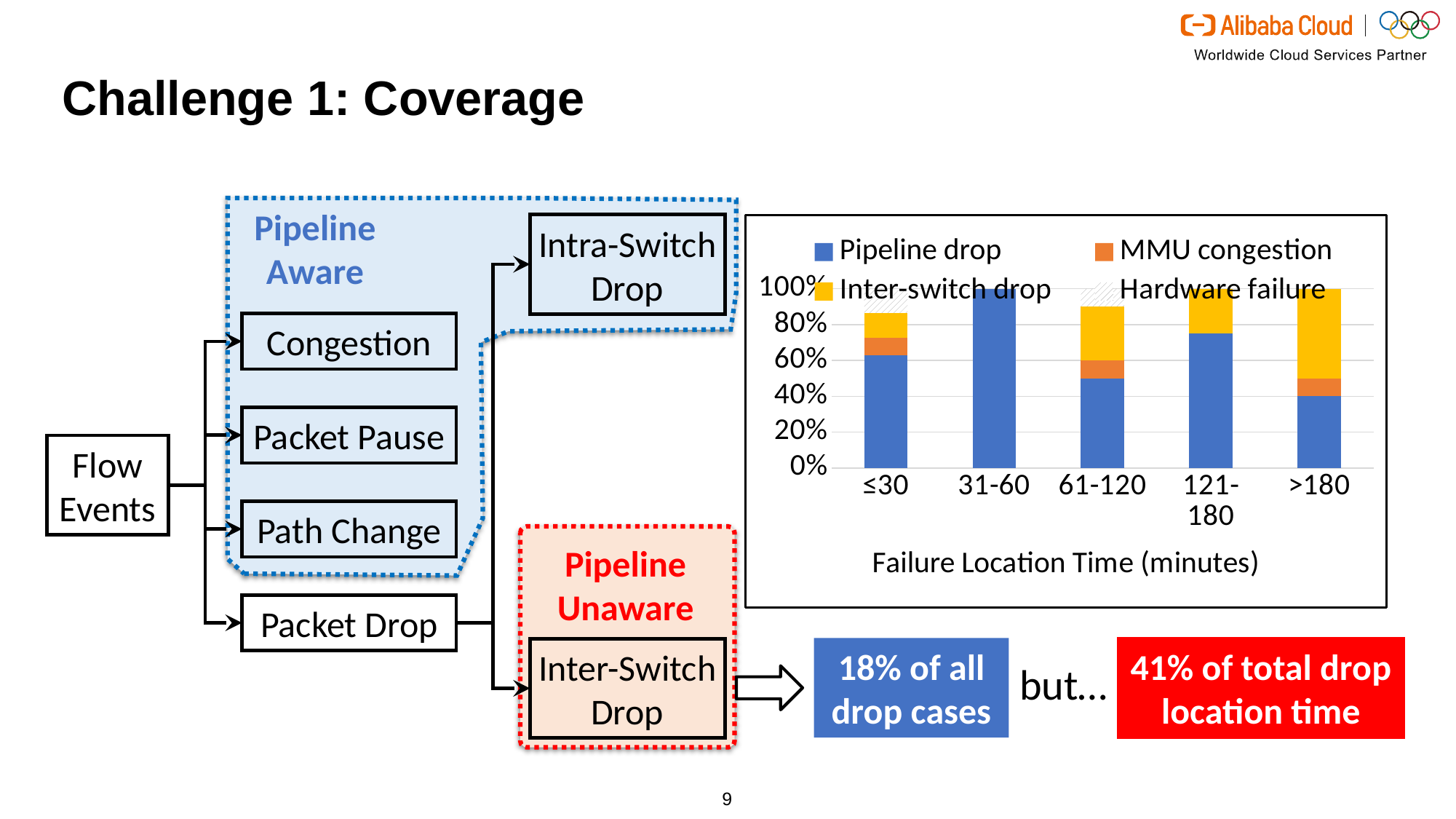
Which has the larger Pipeline drop share, ≤30 or >180? ≤30 Is the Pipeline drop share for 121-180 greater or less than 60%? greater How many series does the chart's legend list? 4 What is the x-axis title of the chart? Failure Location Time (minutes) Is the Pipeline drop share for 31-60 greater or less than 80%? greater Which category has the smallest Pipeline drop share? >180 Which colour represents Pipeline drop in the chart? blue Which category has the largest Pipeline drop share? 31-60 Is the Pipeline drop share for 61-120 greater or less than 80%? less What kind of chart is shown on the slide? stacked bar chart How many categories are shown on the x axis of the chart? 5